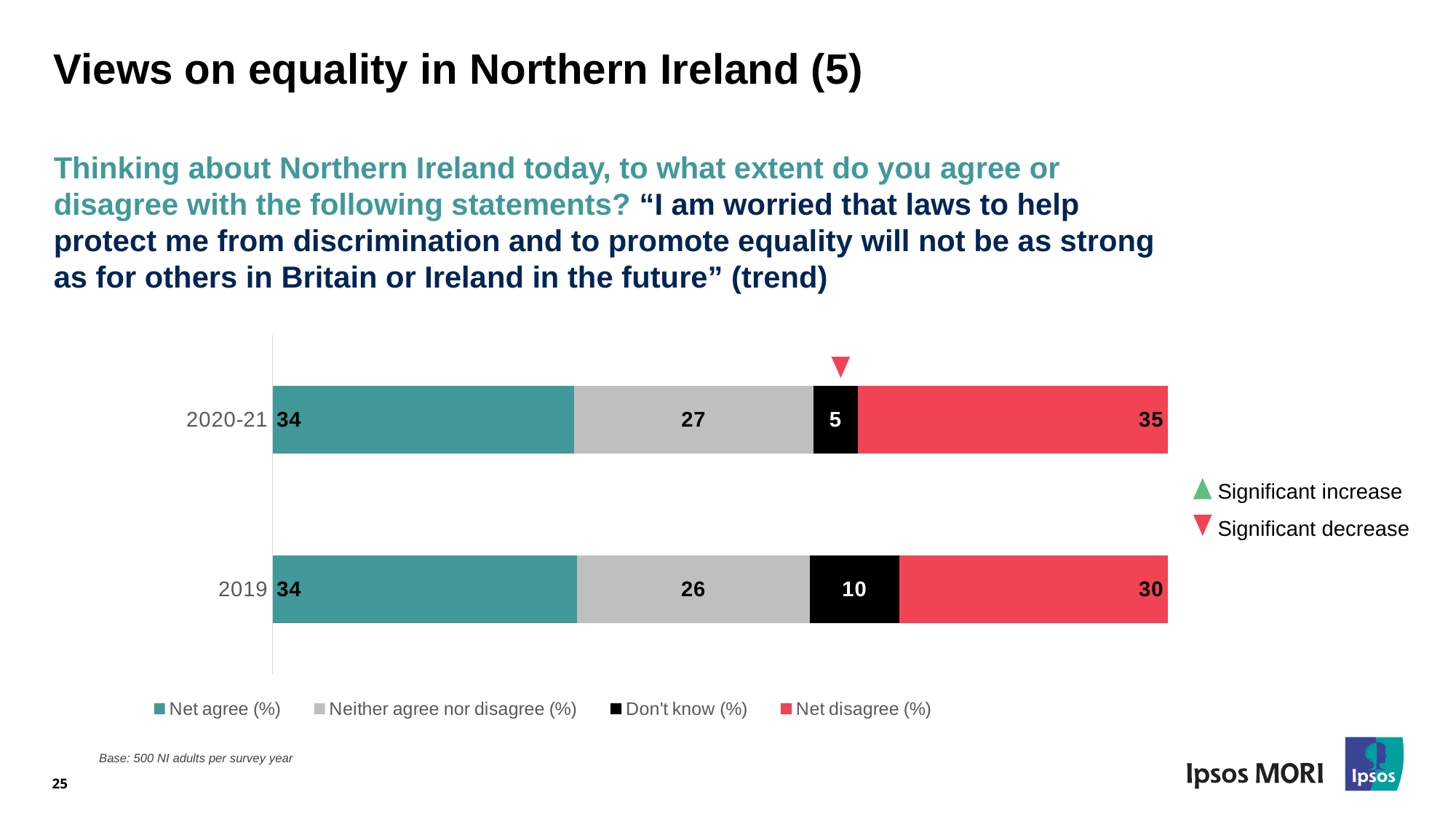
What kind of chart is shown on the slide? Stacked bar chart What is the Net agree (%) value for 2020-21? 34 What is the total of the stacked bar for 2019? 100 What is the difference between the Don't know (%) values for 2019 and 2020-21? 5 What is the Neither agree nor disagree (%) value for 2019? 26 What is the Don't know (%) value for 2019? 10 How many series does the legend list? 4 Which year has the higher Net disagree (%) value? 2020-21 What is the difference between the Net disagree (%) values for 2020-21 and 2019? 5 What is the Net disagree (%) value for 2020-21? 35 How many years are shown on the chart? 2 Which year has the lower Don't know (%) value? 2020-21